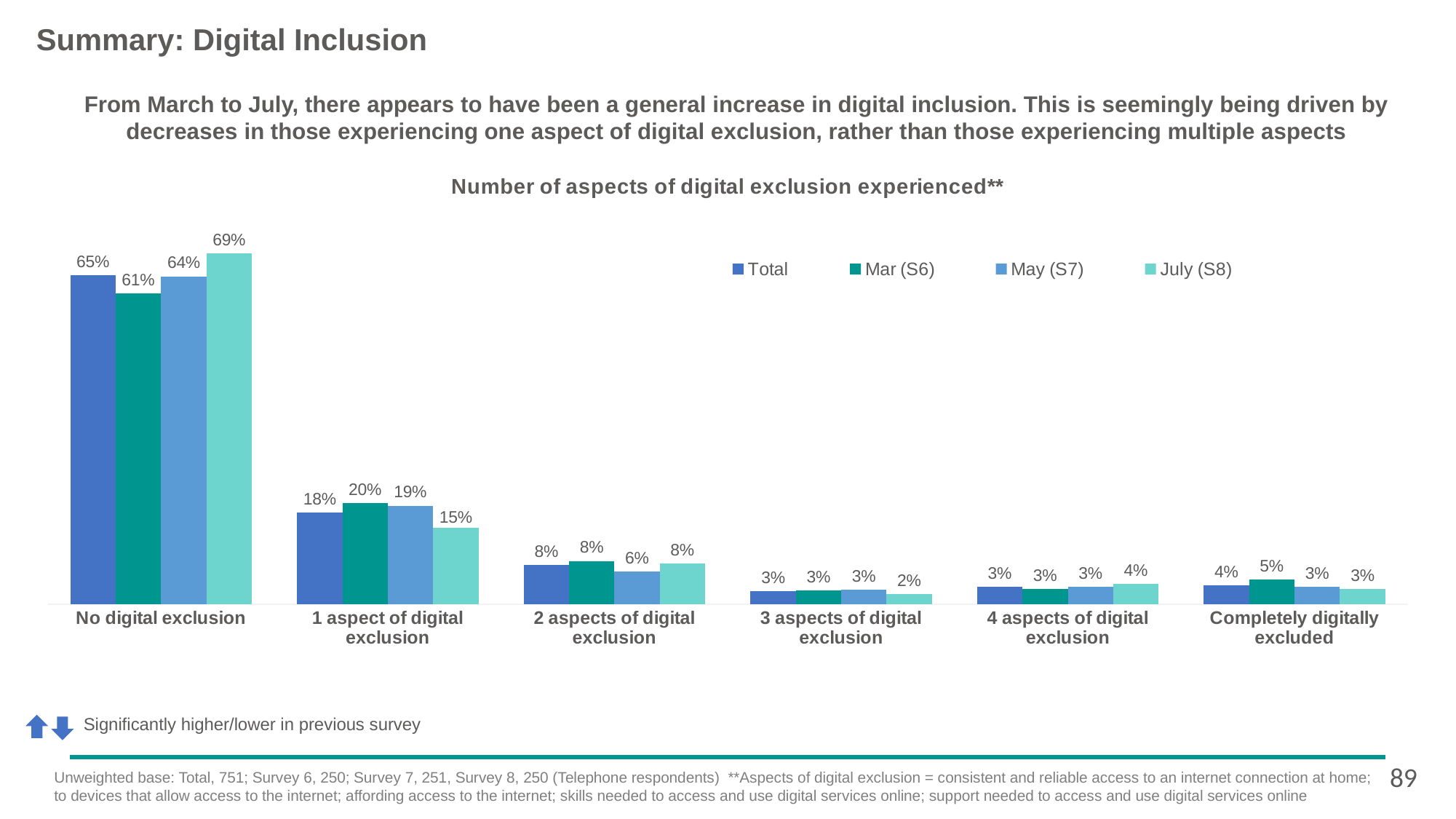
Which category has the lowest July (S8) value? 3 aspects of digital exclusion What is the difference between the Mar (S6) and July (S8) values for 1 aspect of digital exclusion? 5% How many series does the legend list? 4 What is the May (S7) value for 2 aspects of digital exclusion? 6% For No digital exclusion, which is larger: the Mar (S6) value or the May (S7) value? May (S7) What is the difference between the July (S8) and Mar (S6) values for No digital exclusion? 8% What is the Mar (S6) value for 1 aspect of digital exclusion? 20% What kind of chart is shown on the slide? Bar chart What is the Total value for Completely digitally excluded? 4% Which category has the highest July (S8) value? No digital exclusion What is the July (S8) value for No digital exclusion? 69% How many categories are shown on the x axis? 6